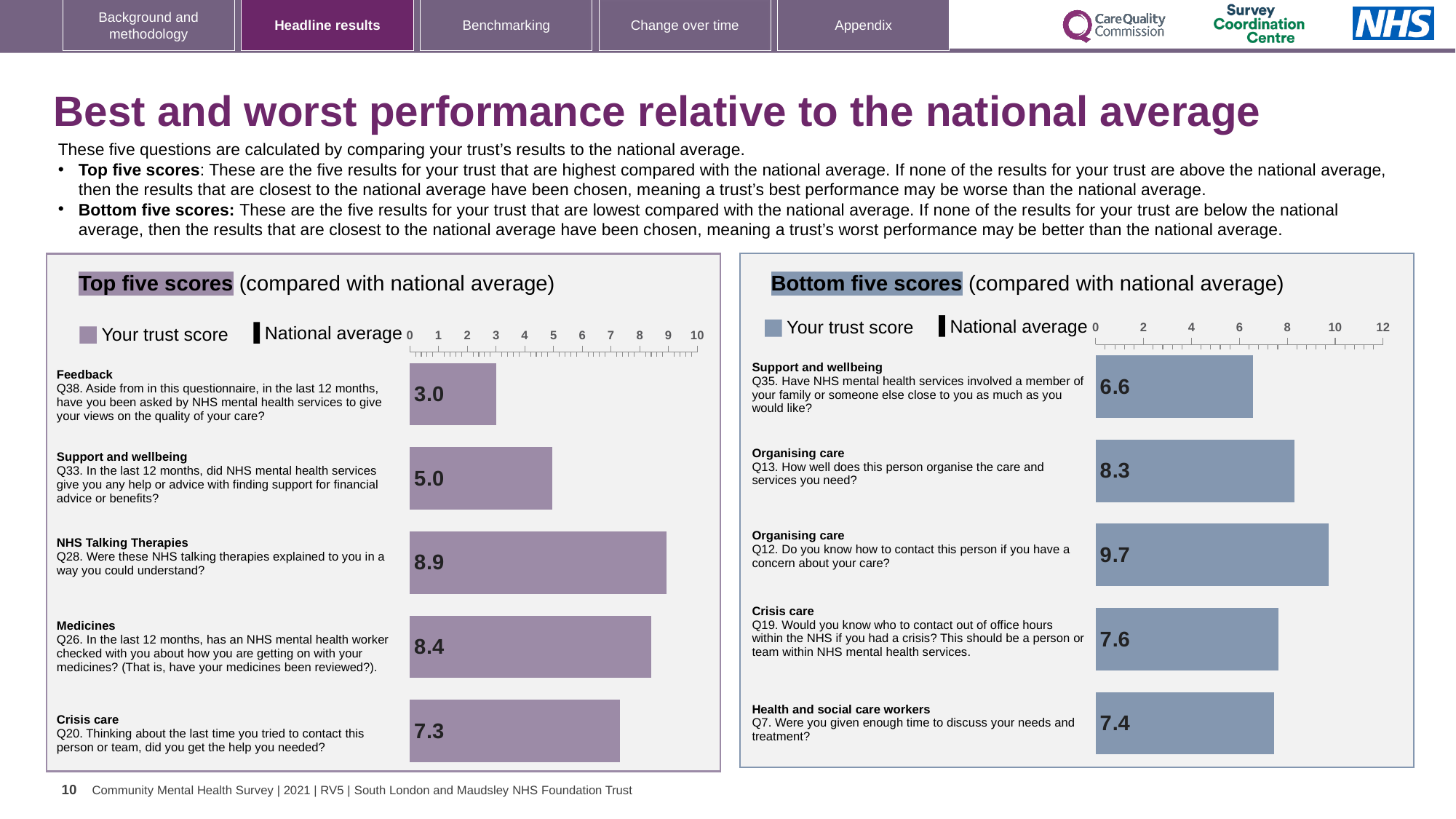
In the Bottom five scores chart, what is the trust score for Organising care Q12 (knowing how to contact this person if you have a concern)? 9.7 In the Top five scores chart, which question has the highest trust score? NHS Talking Therapies (Q28) In the Top five scores chart, what is the difference between the scores for NHS Talking Therapies (Q28) and Feedback (Q38)? 5.9 In the Bottom five scores chart, which question has the highest trust score? Organising care (Q12) In the Bottom five scores chart, which question has the lowest trust score? Support and wellbeing (Q35) In the Top five scores chart, which has the larger trust score: Medicines (Q26) or Crisis care (Q20)? Medicines (Q26) In the Bottom five scores chart, what is the difference between the scores for Organising care Q12 and Support and wellbeing Q35? 3.1 How many bars are plotted in the Bottom five scores chart? 5 What type of chart is the Top five scores chart? Bar chart In the Top five scores chart, which question has the lowest trust score? Feedback (Q38) In the Top five scores chart, what is the trust score for Feedback (Q38)? 3.0 In the Bottom five scores chart, which has the larger trust score: Organising care Q13 or Crisis care Q19? Organising care Q13